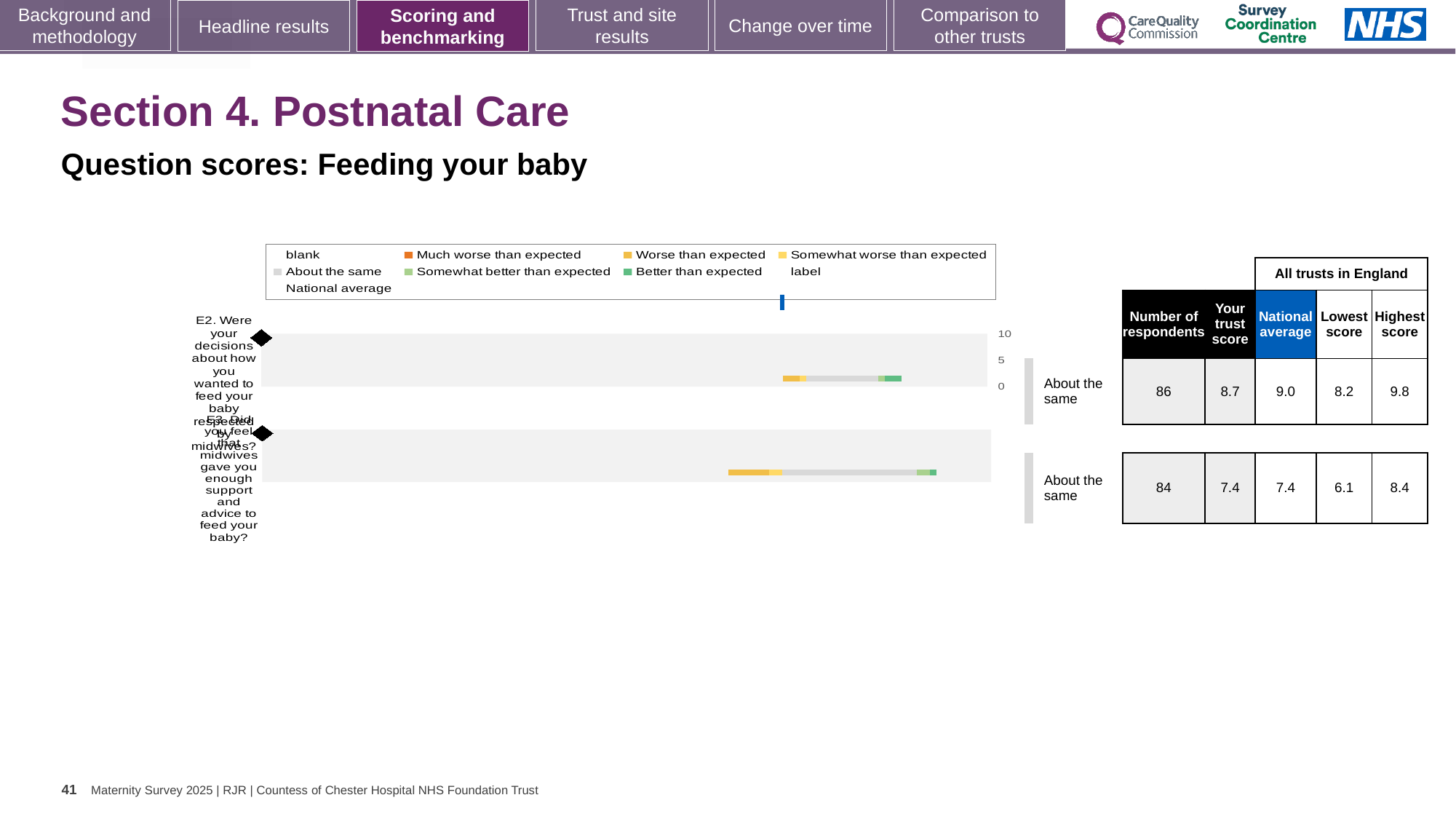
What is the difference between the highest and lowest scores for question E2? 1.6 What is the trust score for question E3? 7.4 What is the national average score for question E2? 9.0 How many respondents answered question E3? 84 How many questions (categories) are plotted in the Feeding your baby chart? 2 What benchmark category is shown next to the bar for question E2? About the same What is the lowest score among all trusts in England for question E3 about midwives giving enough support and advice to feed your baby? 6.1 What kind of chart is used to show the question scores for Feeding your baby? bar chart What is the difference between the highest and lowest scores for question E3? 2.3 What is the trust score for question E2 about decisions on how you wanted to feed your baby being respected by midwives? 8.7 What is the highest score among all trusts in England for question E2? 9.8 Which question has the higher trust score, E2 or E3? E2